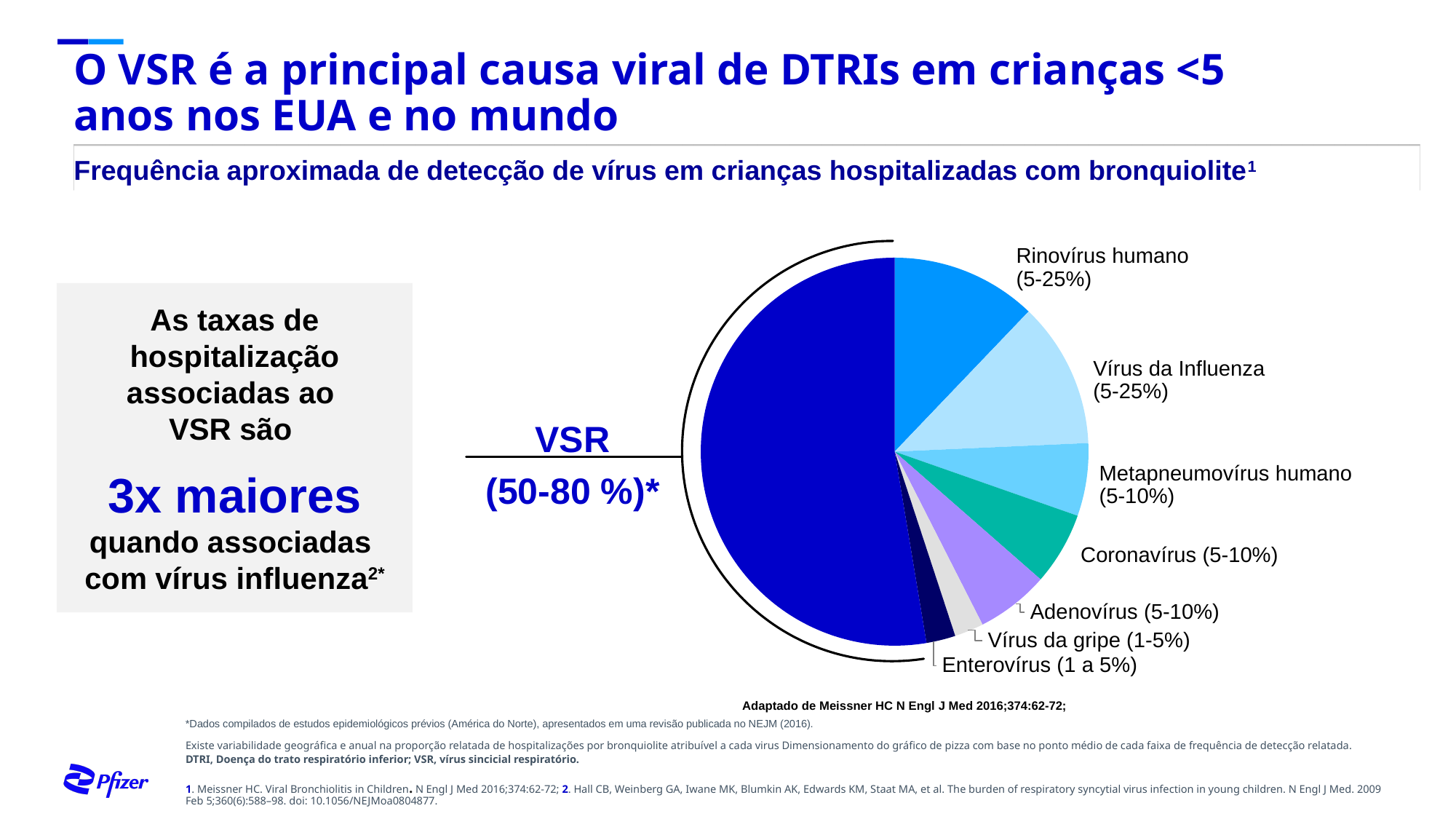
How many slices does the pie chart have? 8 Which slice is larger, Rinovírus humano or Coronavírus? Rinovírus humano What detection frequency range is printed for Enterovírus? 1 a 5% What kind of chart is shown on the slide? Pie chart What detection frequency range is printed for Vírus da Influenza? 5-25% What detection frequency range is printed for Coronavírus? 5-10% What detection frequency range is printed for Rinovírus humano? 5-25% Which slice is larger, VSR or Rinovírus humano? VSR Which virus has the largest slice in the pie chart? VSR What detection frequency range is printed for VSR? 50-80 % What is the title of the chart? Frequência aproximada de detecção de vírus em crianças hospitalizadas com bronquiolite What detection frequency range is printed for Metapneumovírus humano? 5-10%